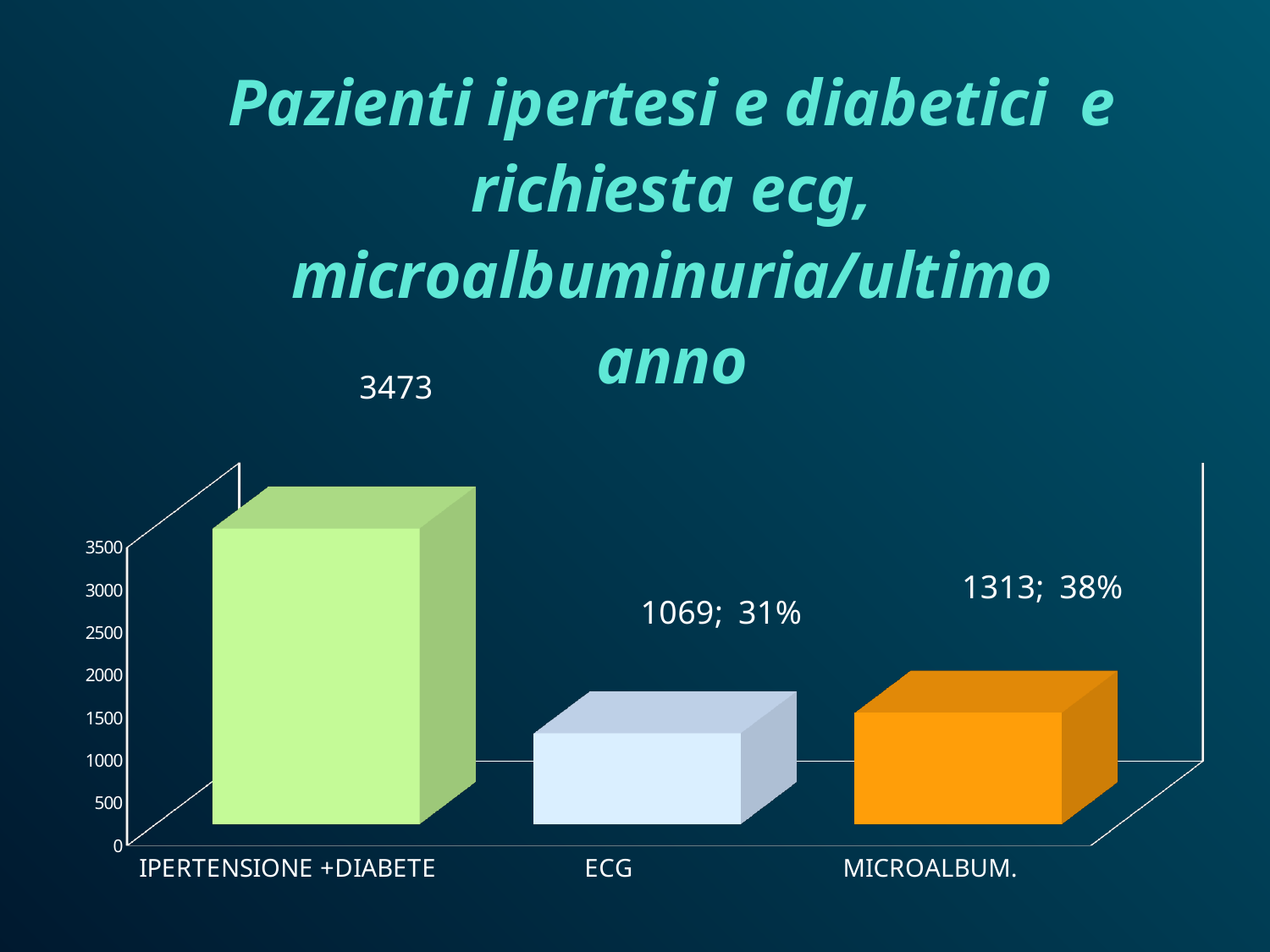
What is the difference between the values for MICROALBUM. and ECG? 244 How many categories are shown on the chart? 3 Which category has the lowest value? ECG What value is shown for ECG? 1069 What percentage is shown next to the MICROALBUM. bar? 38% What value is shown for MICROALBUM.? 1313 What value is shown for IPERTENSIONE +DIABETE? 3473 What kind of chart is shown on the slide? Bar chart What percentage is shown next to the ECG bar? 31% What is the difference between the values for IPERTENSIONE +DIABETE and MICROALBUM.? 2160 Which category has the highest value? IPERTENSIONE +DIABETE Which is larger, the value for MICROALBUM. or the value for ECG? MICROALBUM.